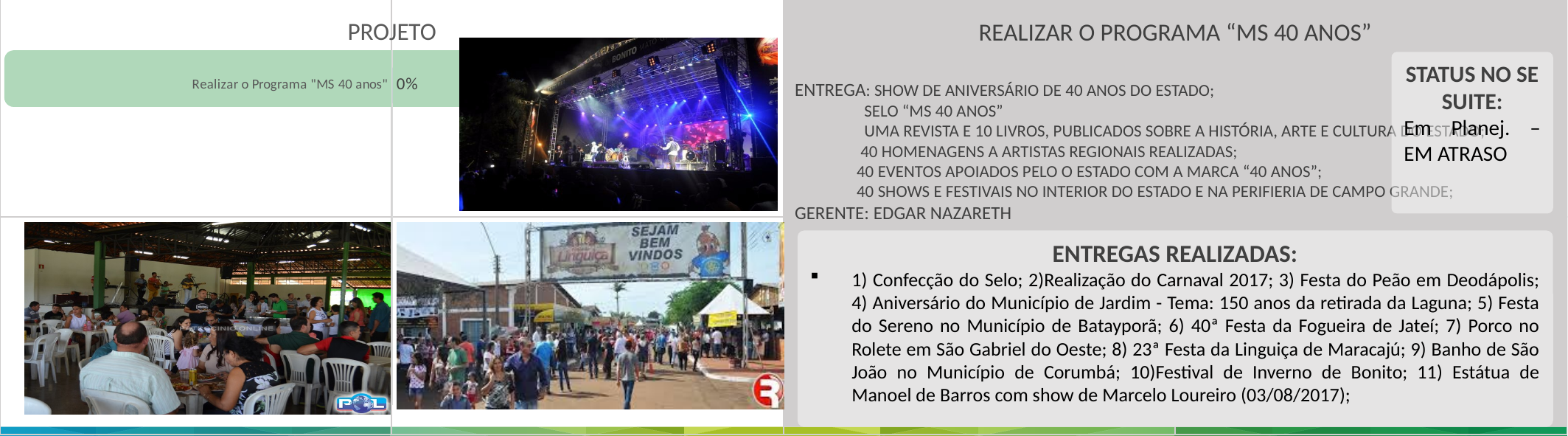
What is the value shown for "Realizar o Programa "MS 40 anos"" in the PROJETO chart? 0% What colour is the bar in the PROJETO chart? green What is the title of the chart on the left of the slide? PROJETO Is the value for "Realizar o Programa "MS 40 anos"" in the PROJETO chart less than 50%? less What kind of chart is the PROJETO chart? bar chart How many categories does the PROJETO chart show? 1